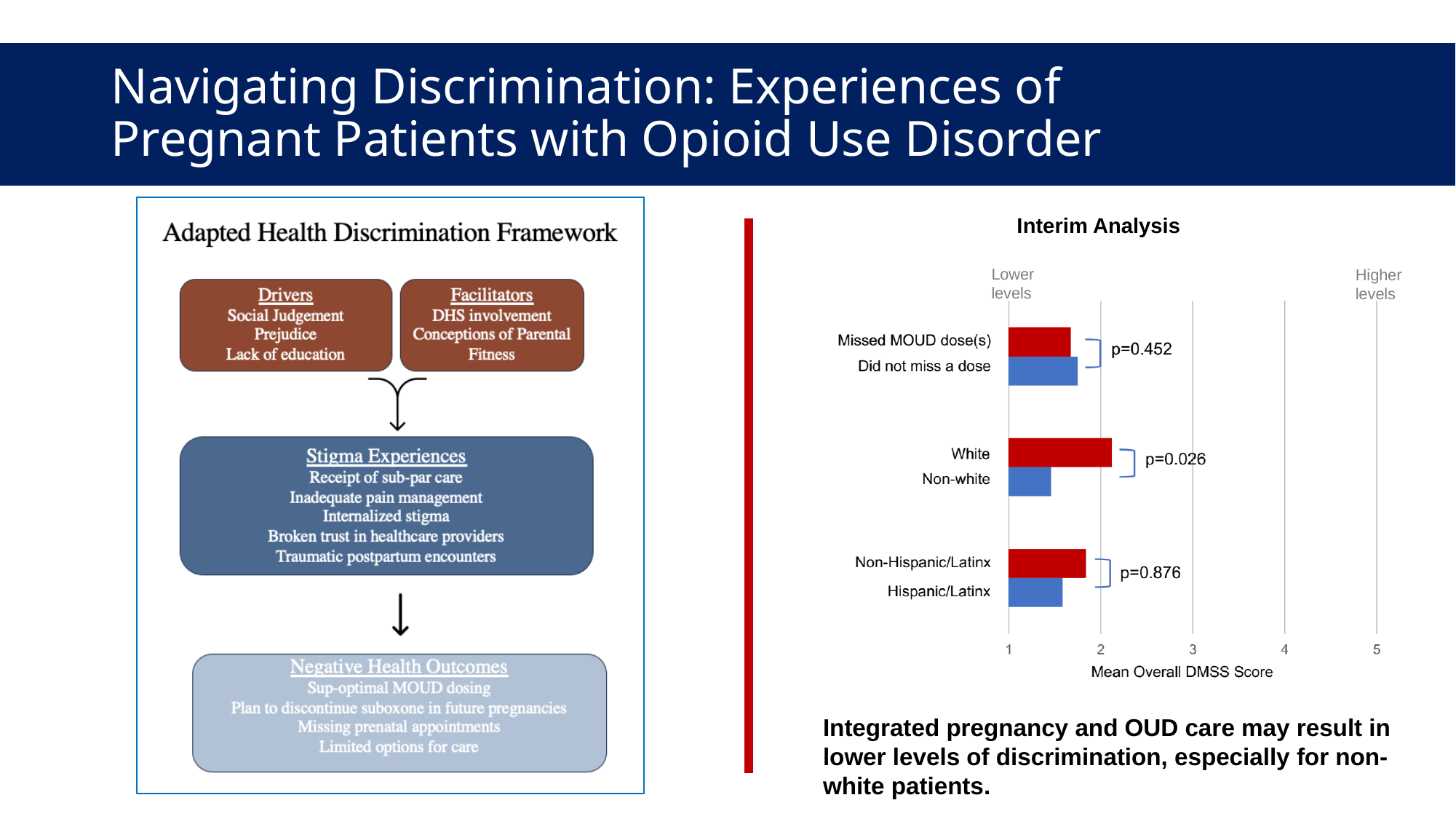
What is the x-axis label of the Interim Analysis chart? Mean Overall DMSS Score In the Interim Analysis chart, is the Mean Overall DMSS Score for White greater or less than 2? greater Which category has the highest Mean Overall DMSS Score in the Interim Analysis chart? White In the Interim Analysis chart, is the Mean Overall DMSS Score for Non-white greater or less than 2? less In the Interim Analysis chart, which has the higher Mean Overall DMSS Score: White or Non-white? White What kind of chart is shown under the title "Interim Analysis"? bar chart What p-value is shown for the comparison between Missed MOUD dose(s) and Did not miss a dose in the Interim Analysis chart? p=0.452 What p-value is shown for the comparison between White and Non-white in the Interim Analysis chart? p=0.026 In the Interim Analysis chart, which has the higher Mean Overall DMSS Score: Non-Hispanic/Latinx or Hispanic/Latinx? Non-Hispanic/Latinx In the Interim Analysis chart, is the Mean Overall DMSS Score for Missed MOUD dose(s) greater or less than 2? less How many bars (categories) are plotted in the Interim Analysis chart? 6